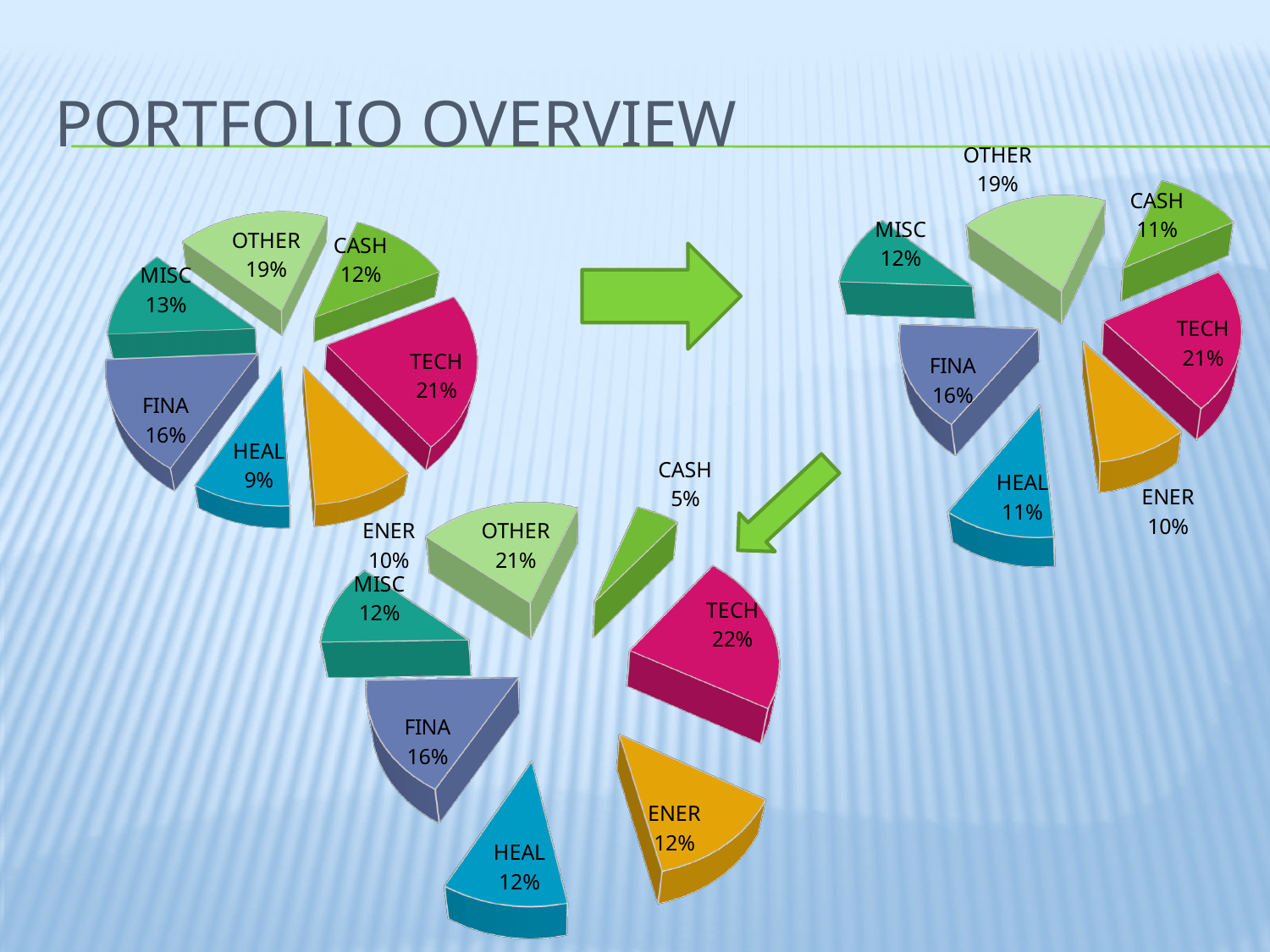
In the bottom pie chart, which category has the largest share? TECH In the bottom pie chart, which is larger, the share for OTHER or the share for FINA? OTHER What kind of chart is the top-left chart? Pie chart In the top-right pie chart, what is the difference between the OTHER share and the CASH share? 8% In the top-left pie chart, which category has the smallest share? HEAL In the top-left pie chart, what share does TECH have? 21% In the bottom pie chart, what share does CASH have? 5% In the top-left pie chart, what is the share for MISC? 13% In the top-right pie chart, what share does HEAL have? 11% How many slices does the bottom pie chart have? 7 In the top-right pie chart, which category has the largest share? TECH How many pie charts are shown on the slide? 3